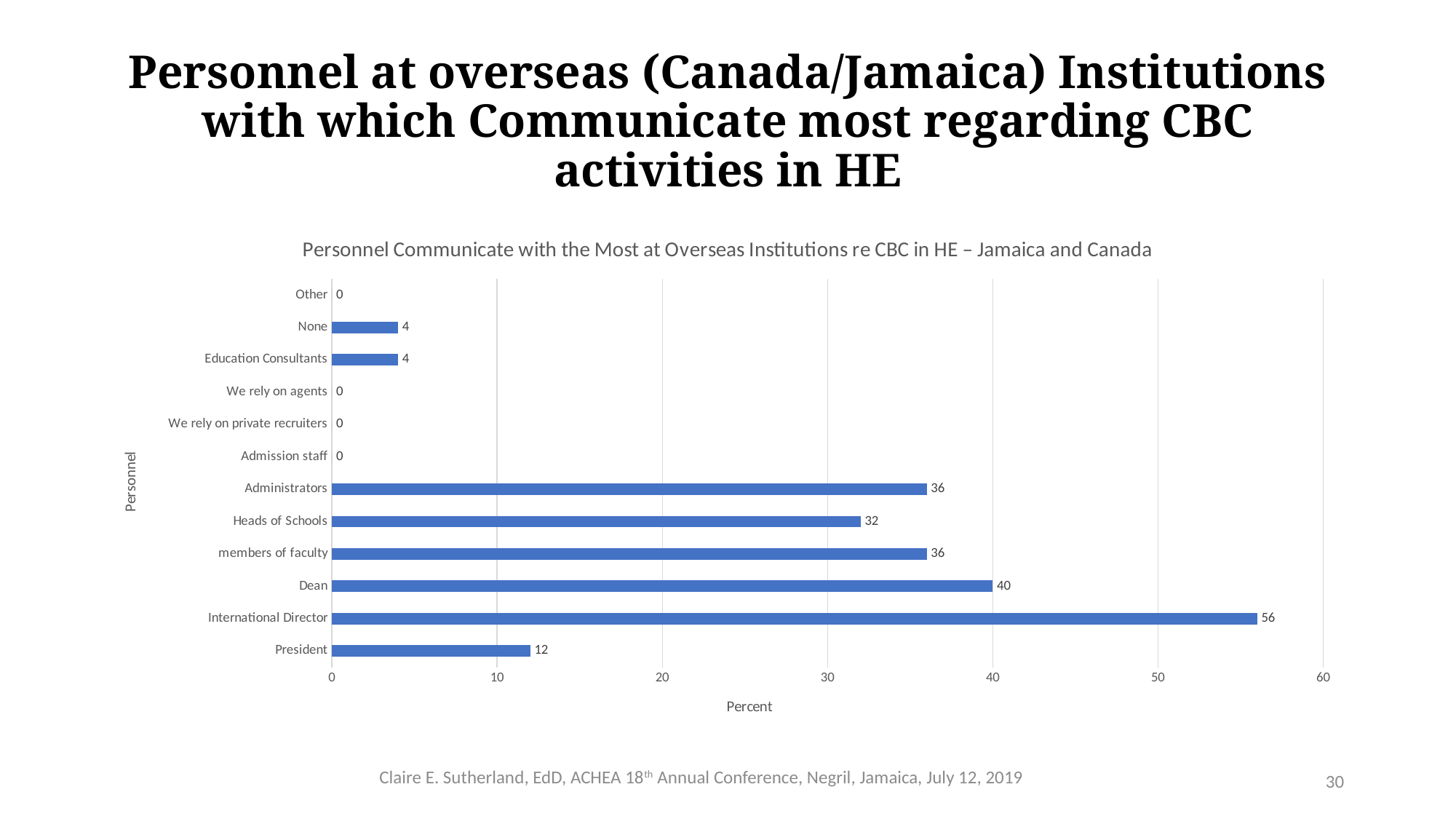
How many categories have a value of 0? 4 What is the value for President? 12 Is the value for Dean greater or less than 30? greater Which is larger, the value for Administrators or the value for Heads of Schools? Administrators What is the label of the x axis? Percent What is the value for Dean? 40 What is the value for International Director? 56 What kind of chart is shown? Bar chart What is the difference between the values for International Director and Dean? 16 What is the value for Heads of Schools? 32 How many categories are shown on the y axis? 12 Which category has the highest value? International Director